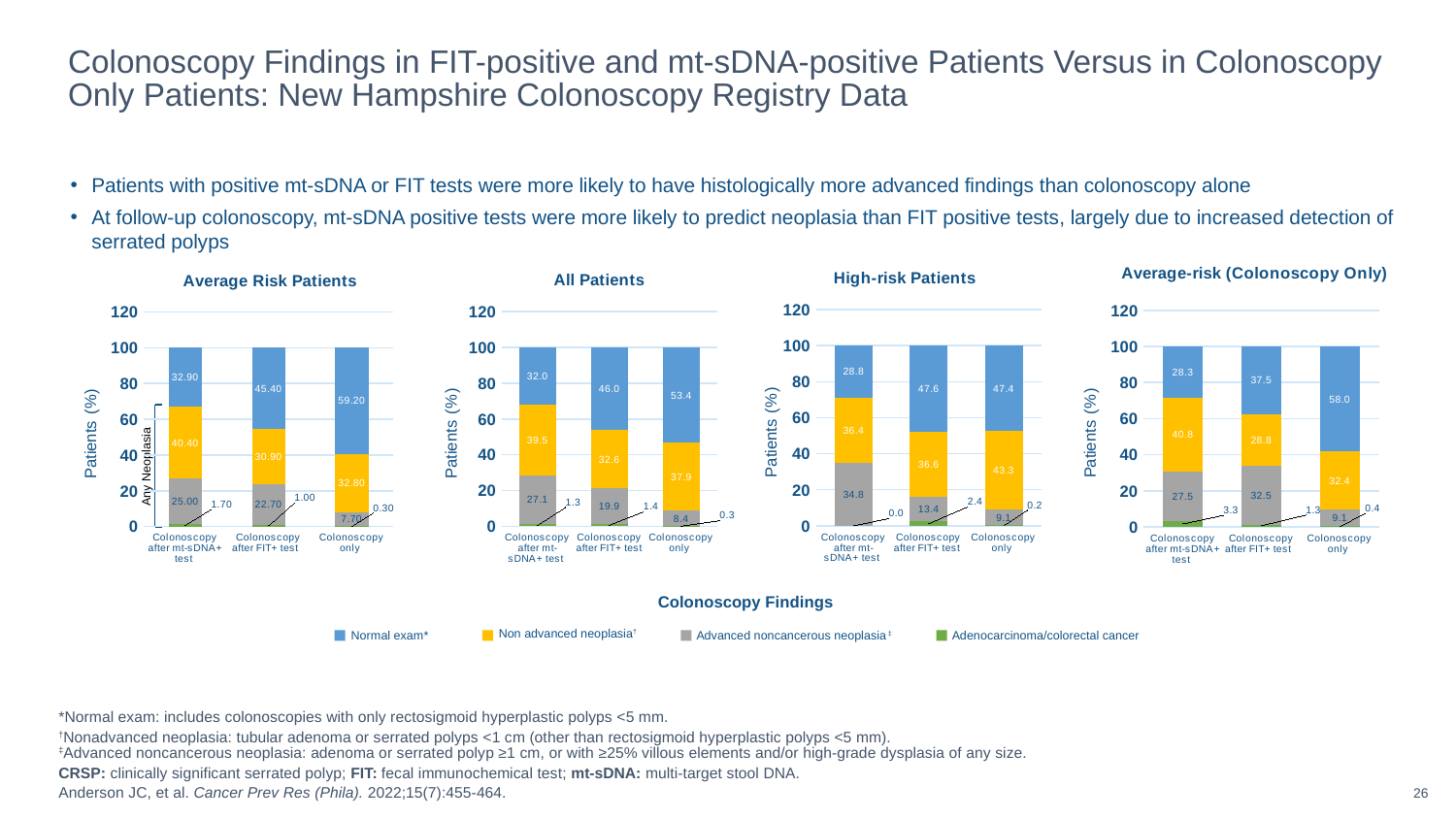
In the 'High-risk Patients' chart, which category has the highest Non advanced neoplasia value? Colonoscopy only In the 'Average Risk Patients' chart, what is the Normal exam value for Colonoscopy only? 59.20 In the 'Average-risk (Colonoscopy Only)' chart, what is the Adenocarcinoma/colorectal cancer value for Colonoscopy after mt-sDNA+ test? 3.3 In the 'Average Risk Patients' chart, what is the difference between the Normal exam values for Colonoscopy only and Colonoscopy after mt-sDNA+ test? 26.30 How many series does the shared legend list for the charts? 4 In the 'All Patients' chart, which category has the lowest Advanced noncancerous neoplasia value? Colonoscopy only What type of chart is the 'High-risk Patients' chart? Stacked bar chart In the 'High-risk Patients' chart, what is the Advanced noncancerous neoplasia value for Colonoscopy after FIT+ test? 13.4 Which legend entry is shown in green? Adenocarcinoma/colorectal cancer How many categories are shown on the x axis of the 'All Patients' chart? 3 In the 'Average-risk (Colonoscopy Only)' chart, which is larger: the Advanced noncancerous neoplasia value for Colonoscopy after FIT+ test or for Colonoscopy after mt-sDNA+ test? Colonoscopy after FIT+ test In the 'All Patients' chart, what is the Non advanced neoplasia value for Colonoscopy after mt-sDNA+ test? 39.5